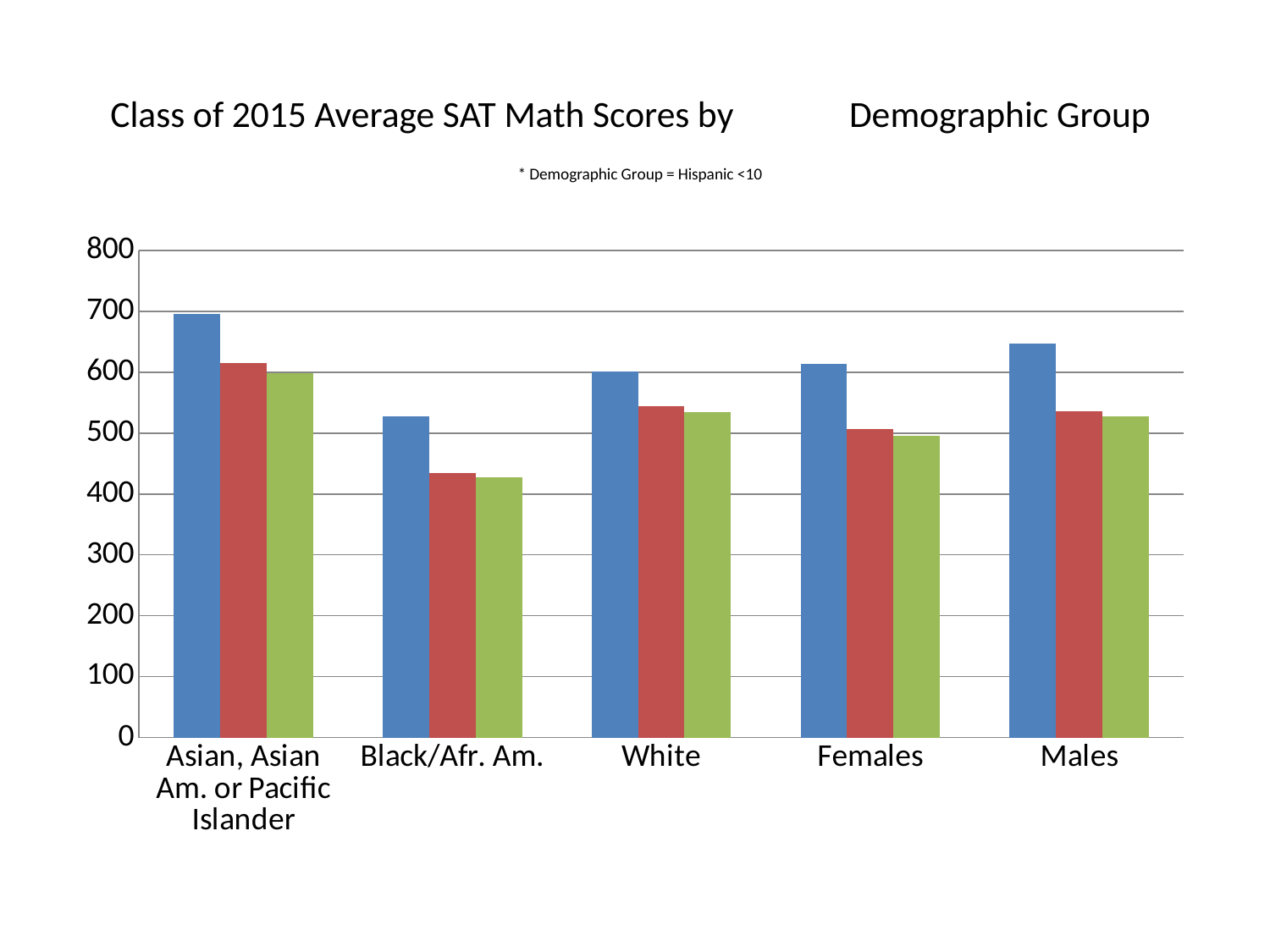
What is the title of the chart on the slide? Class of 2015 Average SAT Math Scores by Demographic Group Which demographic group has the shortest red bar in the chart? Black/Afr. Am. What kind of chart is shown on the slide? bar chart Is the blue bar for Males taller or shorter than the blue bar for Females? taller Is the blue bar for Males greater or less than 600? greater Is the red bar for Black/Afr. Am. greater or less than 500? less How many demographic groups are shown along the x axis of the chart? 5 Is the red bar for Asian, Asian Am. or Pacific Islander taller or shorter than the red bar for White? taller Which demographic group has the tallest blue bar in the chart? Asian, Asian Am. or Pacific Islander Which demographic group has the shortest blue bar in the chart? Black/Afr. Am. How many bars are plotted for each demographic group in the chart? 3 Is the blue bar for Asian, Asian Am. or Pacific Islander greater or less than 600? greater